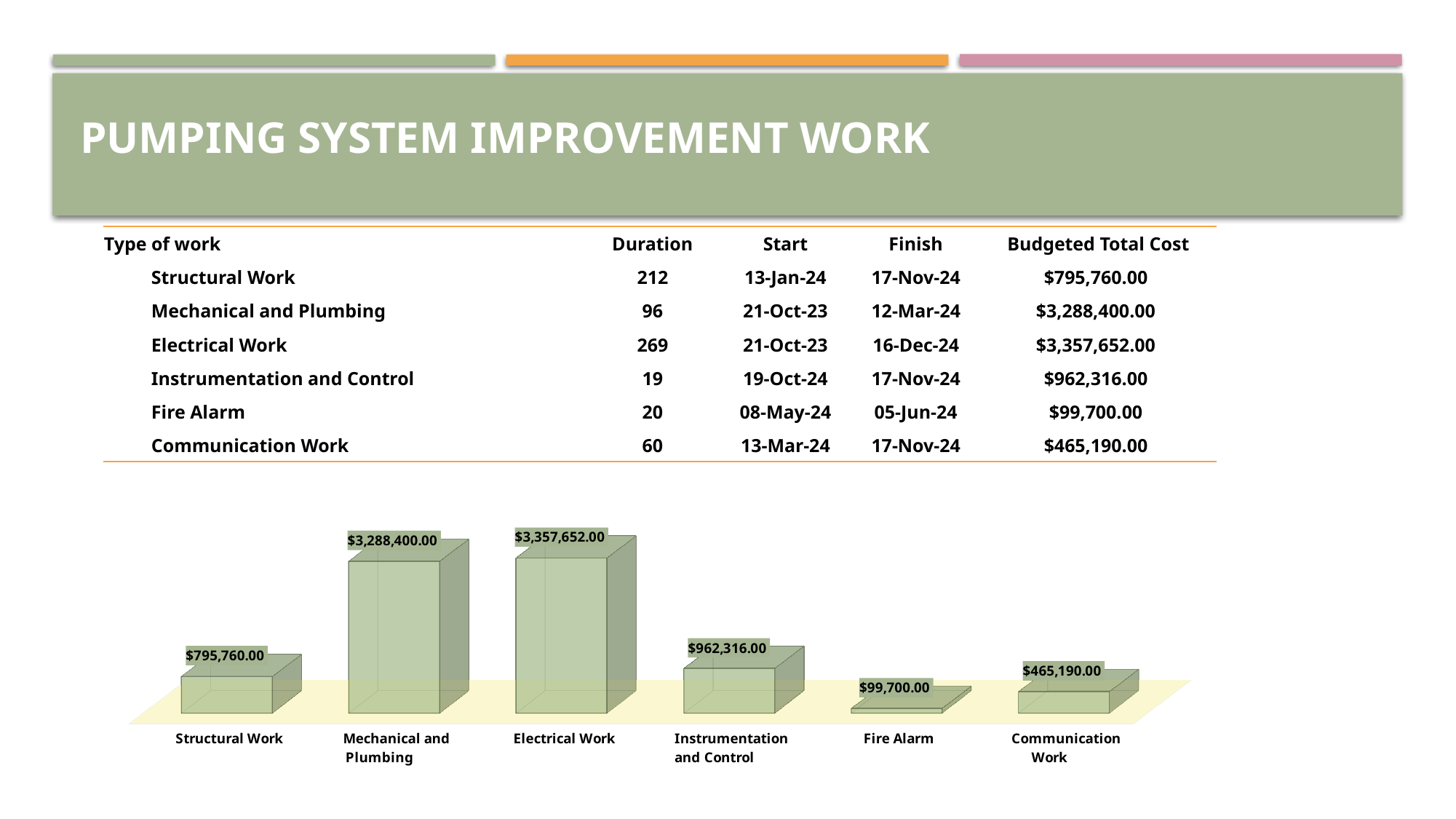
What value is labelled on the Fire Alarm bar? $99,700.00 What value does the chart show for Mechanical and Plumbing? $3,288,400.00 Which type of work has the lowest bar in the chart? Fire Alarm What value does the chart show for Communication Work? $465,190.00 How many types of work are plotted in the chart? 6 What kind of chart is shown on the slide? Bar chart Which is larger, the value for Instrumentation and Control or the value for Fire Alarm? Instrumentation and Control Which is larger, the value for Structural Work or the value for Communication Work? Structural Work What is the budgeted total cost shown for Structural Work in the chart? $795,760.00 What is the difference between the values for Electrical Work and Mechanical and Plumbing? $69,252.00 Which type of work has the highest bar in the chart? Electrical Work What is the difference between the values for Instrumentation and Control and Structural Work? $166,556.00